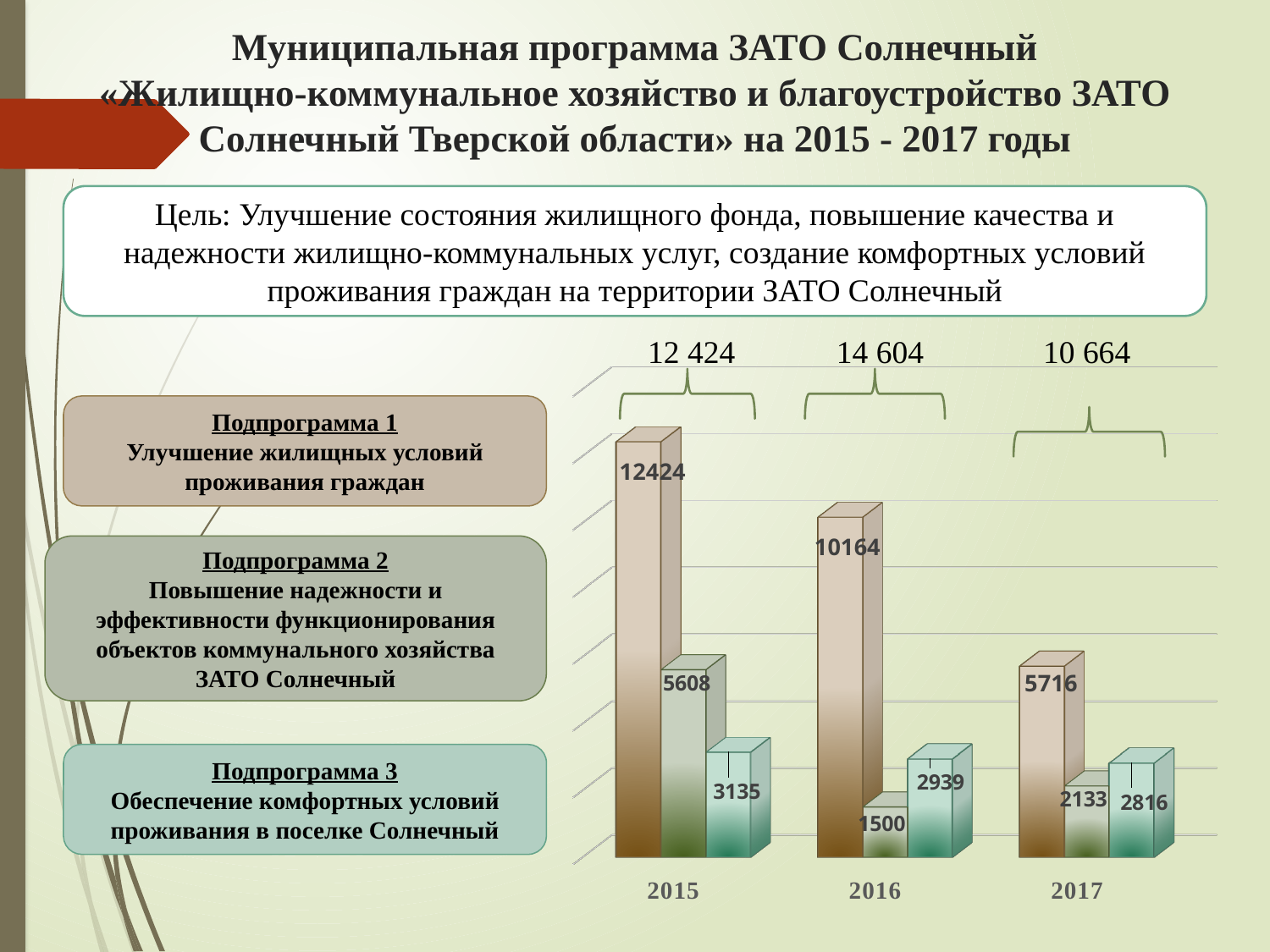
What is the value of the third bar in the 2016 group? 2939 What is the value of the second bar in the 2015 group? 5608 Which bar has the lowest value in the whole chart? the second bar in 2016 (1500) Which is larger: the third bar in 2017 (2816) or the second bar in 2017 (2133)? the third bar (2816) Which year has the tallest bar in the chart? 2015 What type of chart is shown on the slide? bar chart What is the difference between the first bar in 2015 (12424) and the first bar in 2016 (10164)? 2260 What is the value of the second bar in the 2016 group? 1500 What is the value of the first bar in the 2017 group? 5716 What is the value of the first (tallest) bar in the 2015 group? 12424 How many year categories are shown on the x axis of the chart? 3 Does the value of the first bar decrease from 2015 to 2017? yes